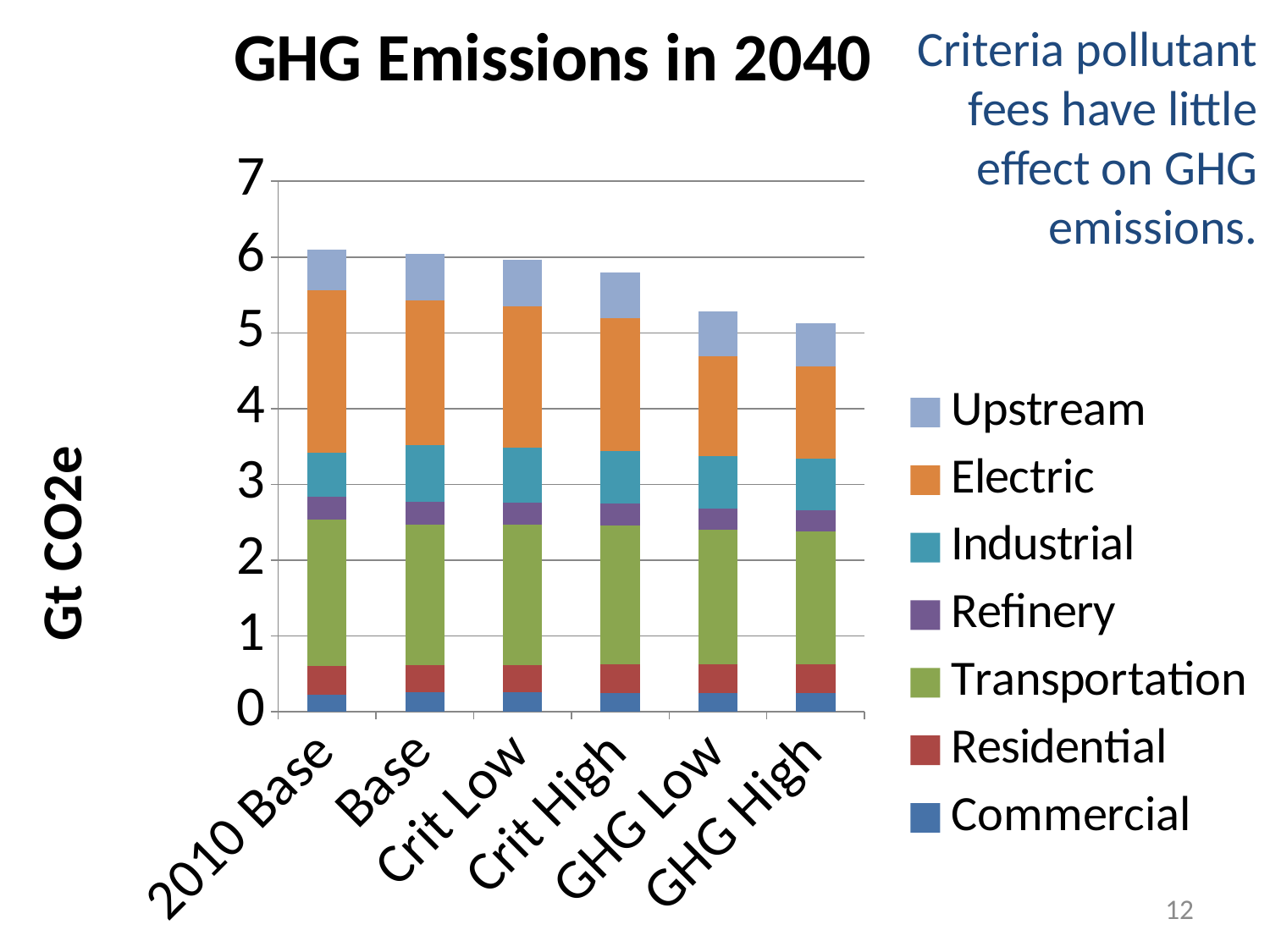
What is the label on the y axis of the chart? Gt CO2e Which has the larger total GHG emissions, Base or GHG Low? Base Which scenario has the lowest total GHG emissions in the chart? GHG High Is the total for GHG Low greater or less than 5 Gt CO2e? greater How many scenarios (bars) are shown on the x axis of the GHG Emissions in 2040 chart? 6 Do the total GHG emissions rise or fall moving from 2010 Base to GHG High along the x axis? fall Is the total for 2010 Base greater or less than 6 Gt CO2e? greater Which series is shown in green in the chart's legend? Transportation How many series does the legend of the GHG Emissions in 2040 chart list? 7 Is the total for Crit High greater or less than 6 Gt CO2e? less What kind of chart is shown on the slide? stacked bar chart